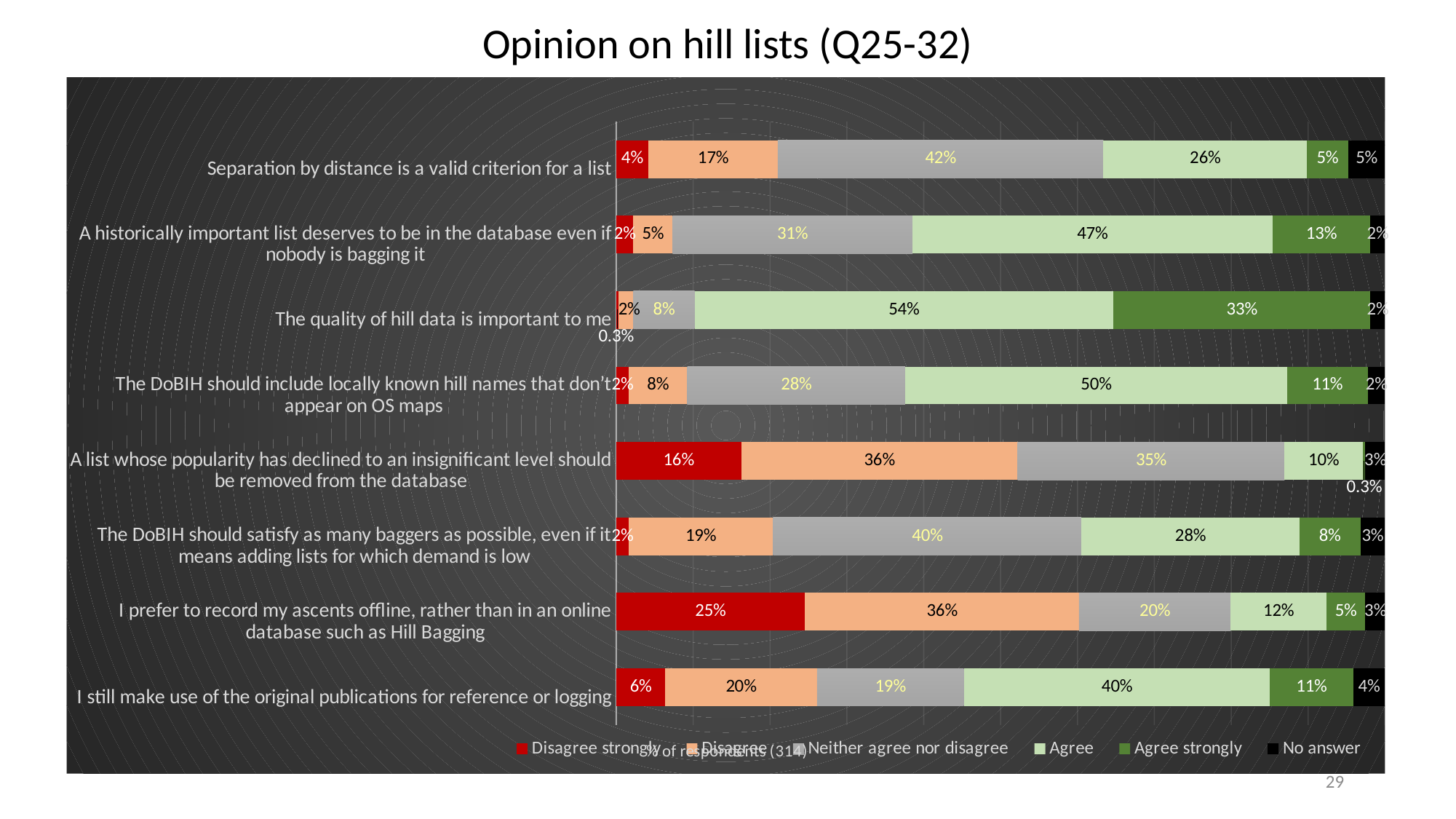
What percentage answered 'Disagree strongly' to 'I prefer to record my ascents offline, rather than in an online database such as Hill Bagging'? 25% What is the 'Agree strongly' value for 'A historically important list deserves to be in the database even if nobody is bagging it'? 13% Which statement has the highest 'Disagree strongly' percentage? I prefer to record my ascents offline, rather than in an online database such as Hill Bagging What is the title of the chart? Opinion on hill lists (Q25-32) Which statement has the highest 'Agree strongly' percentage? The quality of hill data is important to me Which is larger: the 'Disagree' value for 'A list whose popularity has declined to an insignificant level should be removed from the database' or the 'Disagree' value for 'I still make use of the original publications for reference or logging'? A list whose popularity has declined to an insignificant level should be removed from the database What is the 'Neither agree nor disagree' value for 'Separation by distance is a valid criterion for a list'? 42% What kind of chart is shown on the slide? Stacked bar chart What is the difference between the 'Agree' percentages for 'The DoBIH should include locally known hill names that don't appear on OS maps' and 'I still make use of the original publications for reference or logging'? 10% How many series does the legend list? 6 How many statements (categories) are plotted in the chart? 8 What percentage of respondents answered 'Agree' to 'The quality of hill data is important to me'? 54%